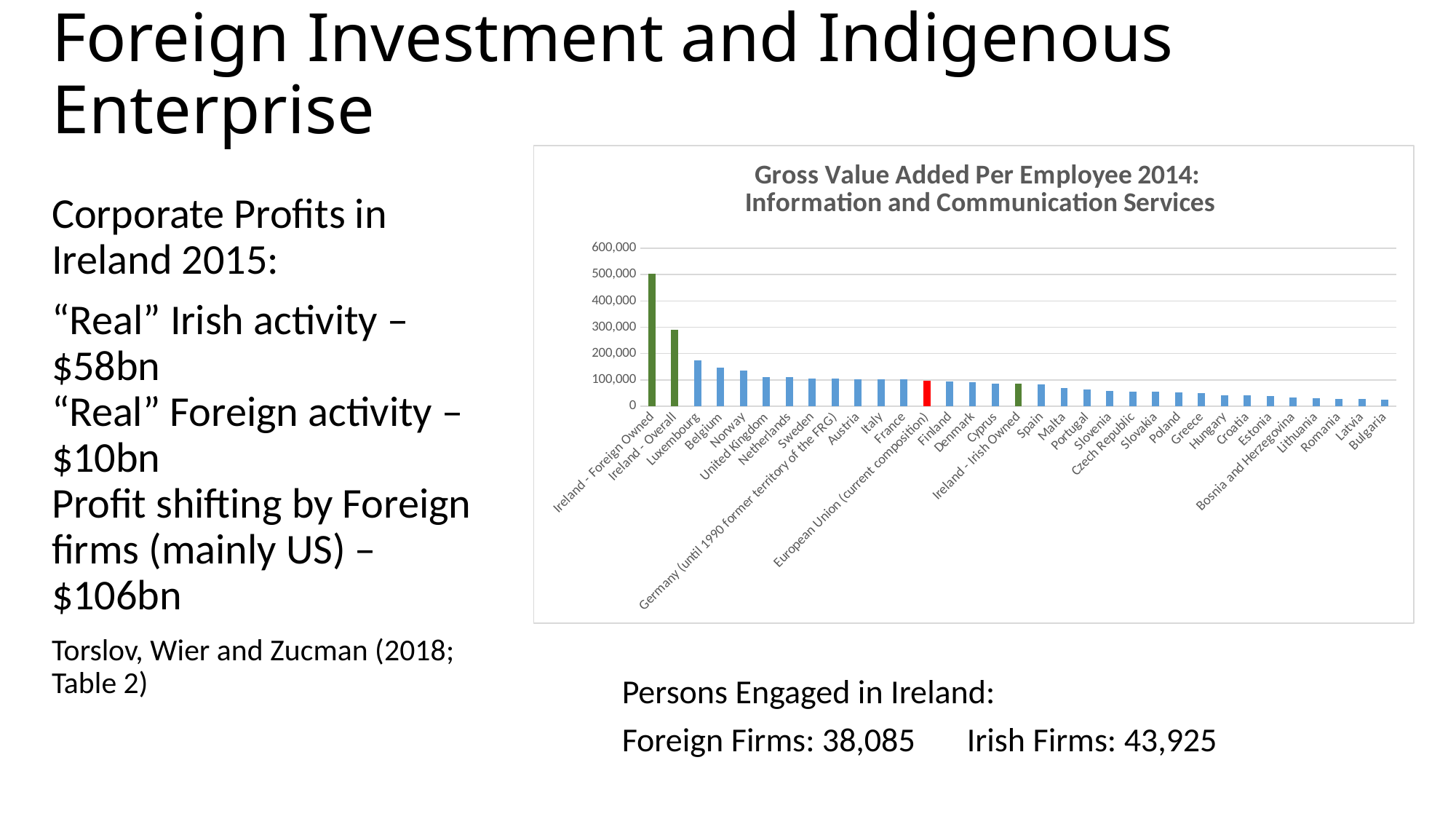
Is the value for Ireland - Irish Owned greater or less than 100,000? less What is the title of the chart? Gross Value Added Per Employee 2014: Information and Communication Services Is the value for Ireland - Overall greater or less than 200,000? greater Which has a higher value, Luxembourg or Belgium? Luxembourg What kind of chart is shown on the slide? Bar chart Is the value for Luxembourg greater or less than 100,000? greater How many categories are plotted in the chart? 33 Which category has the lowest gross value added per employee in the chart? Bulgaria Which category has the highest gross value added per employee in the chart? Ireland - Foreign Owned Which has a higher value, Ireland - Overall or Ireland - Irish Owned? Ireland - Overall Do the bar values rise or fall moving from left to right along the x axis? Fall